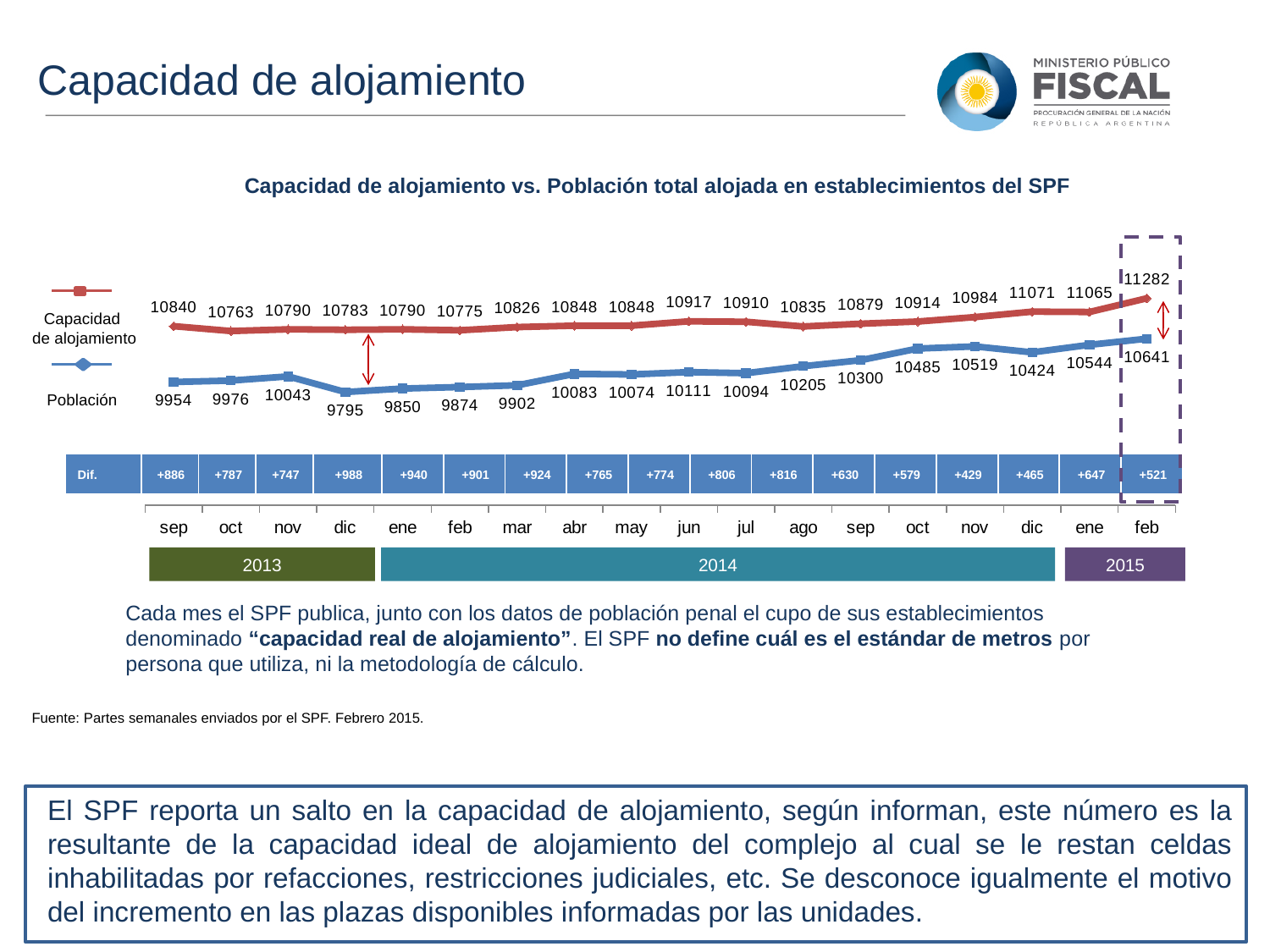
What is the difference between Capacidad de alojamiento and Población in dic 2013? 988 How many series does the legend list? 2 In which month is Capacidad de alojamiento at its lowest? oct 2013 In which month is Población at its lowest? dic 2013 Which is larger in nov 2014: Población or Capacidad de alojamiento? Capacidad de alojamiento What is the value of Población in sep 2014? 10300 What is the title of the chart? Capacidad de alojamiento vs. Población total alojada en establecimientos del SPF How many monthly data points are plotted for each series? 18 In which month is Capacidad de alojamiento at its highest? feb 2015 What is the value of Capacidad de alojamiento in feb 2015? 11282 What type of chart is shown on the slide? line chart What is the value of Población in dic 2013? 9795